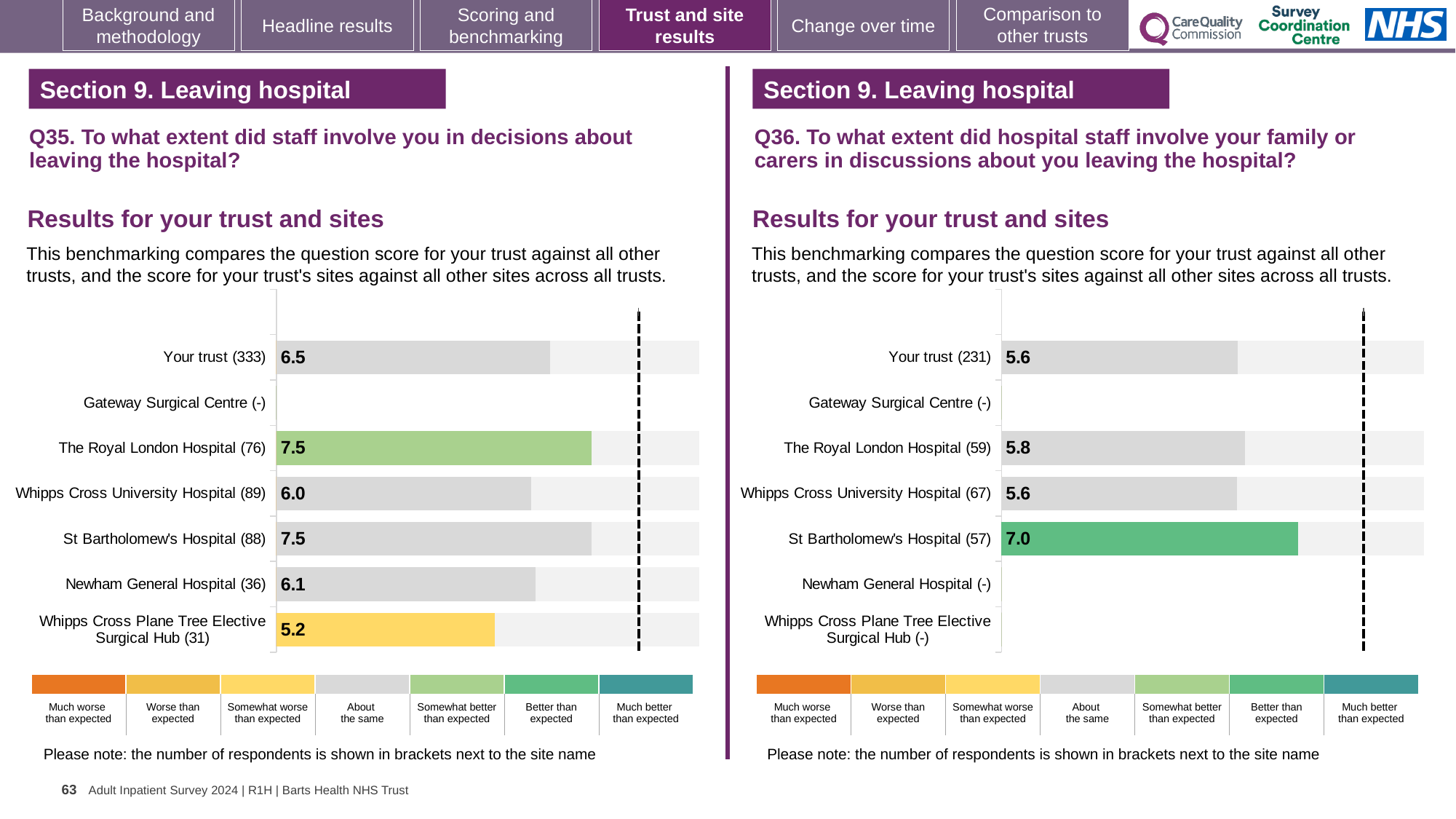
In the Q35 chart on the left, which has the higher score, Newham General Hospital or Whipps Cross University Hospital? Newham General Hospital In the Q36 chart on the right, what is the difference between the scores for St Bartholomew's Hospital and Your trust? 1.4 In the Q36 chart on the right, which has the higher score, The Royal London Hospital or Whipps Cross University Hospital? The Royal London Hospital In the Q36 chart on the right, what is the score for St Bartholomew's Hospital? 7.0 In the Q35 chart on the left, which site has the lowest score? Whipps Cross Plane Tree Elective Surgical Hub In the Q36 chart on the right, how many rows show a numeric score? 4 What type of chart is used on the left for Q35? Bar chart In the Q35 chart on the left, what colour is the bar for Whipps Cross Plane Tree Elective Surgical Hub? Yellow In the Q35 chart on the left, what is the difference between the scores for The Royal London Hospital and Whipps Cross University Hospital? 1.5 In the Q36 chart on the right, which site has the highest score? St Bartholomew's Hospital In the Q35 chart on the left, what is the score for Whipps Cross Plane Tree Elective Surgical Hub? 5.2 In the Q35 chart on the left, what is the score for Your trust? 6.5